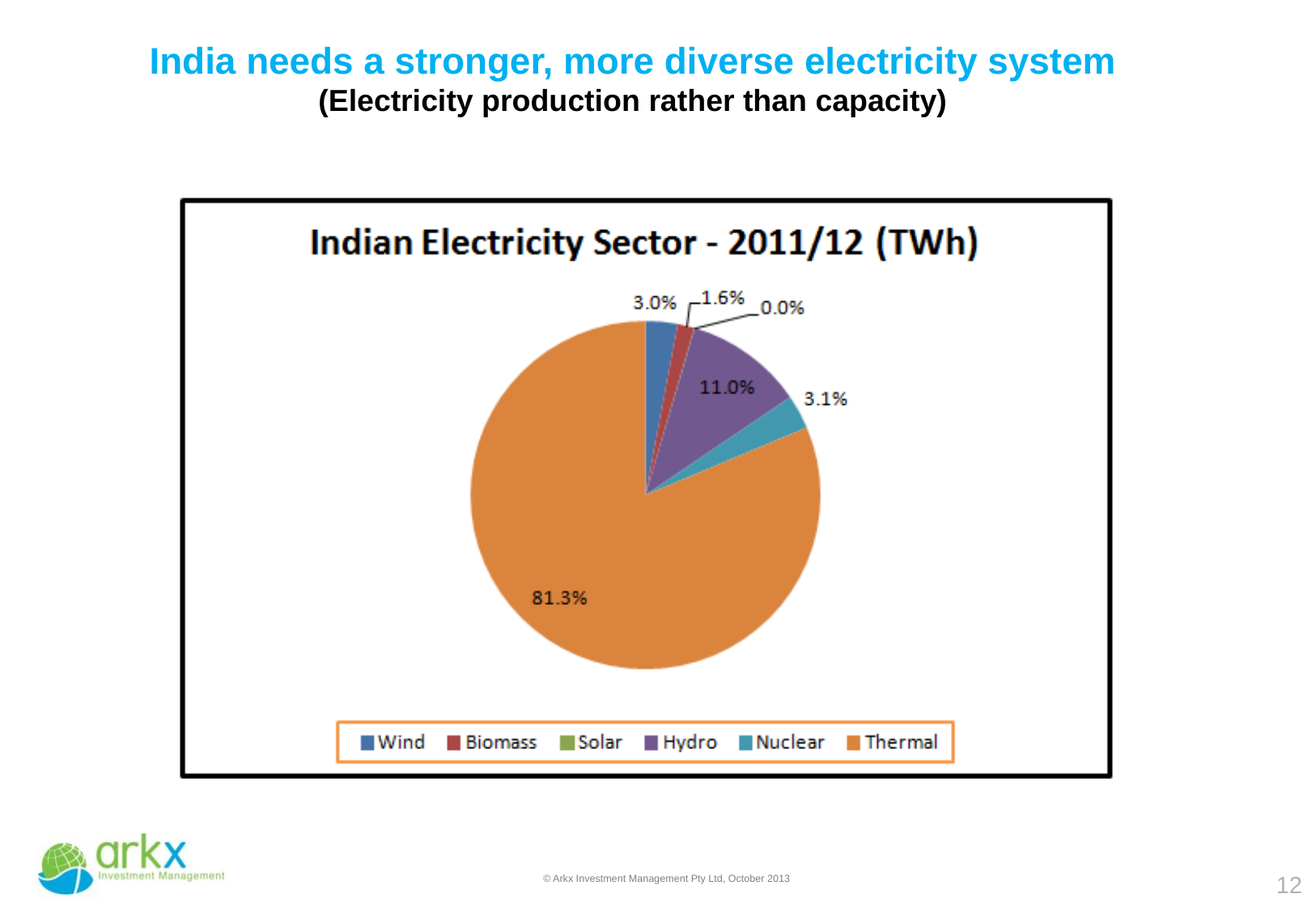
What is the value shown for Biomass? 1.6% What is the value shown for Nuclear? 3.1% What is the title of the chart? Indian Electricity Sector - 2011/12 (TWh) What type of chart is shown on the slide? pie chart How many categories does the legend list? 6 What share of the pie does Thermal account for? 81.3% What share of the pie does Hydro account for? 11.0% Which category has the smallest slice of the pie? Solar What is the value shown for Wind? 3.0% Which category has the largest slice of the pie? Thermal What is the difference in percentage points between Hydro and Nuclear? 7.9% What is the value shown for Solar? 0.0%